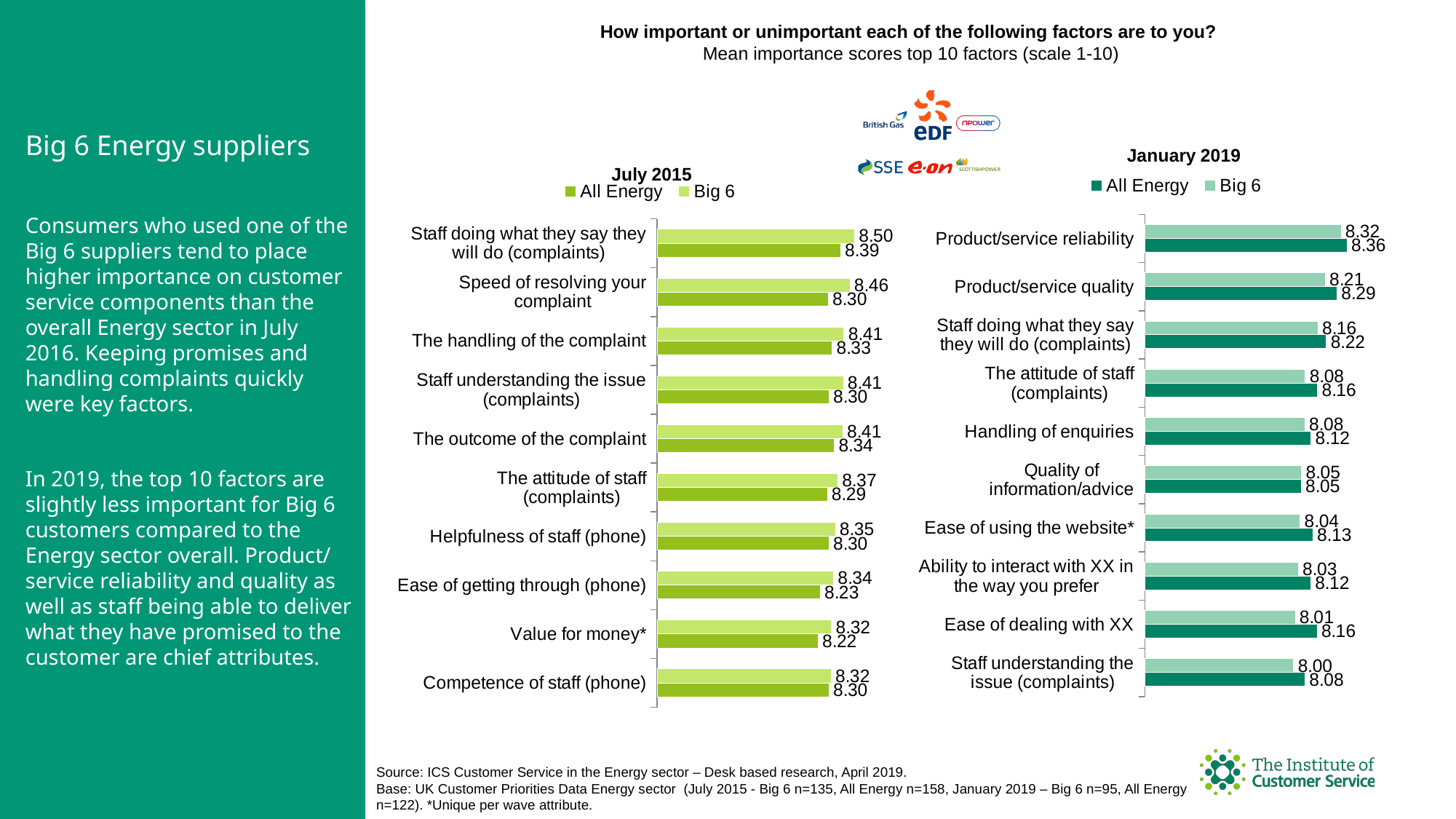
In the July 2015 chart, what is the Big 6 score for 'Staff doing what they say they will do (complaints)'? 8.50 In the July 2015 chart, which factor has the highest Big 6 score? Staff doing what they say they will do (complaints) In the July 2015 chart, what is the difference between the Big 6 and All Energy scores for 'Speed of resolving your complaint'? 0.16 In the January 2019 chart, what is the All Energy score for 'Product/service reliability'? 8.36 What type of chart is used for the July 2015 data? Bar chart How many series does the legend of the January 2019 chart list? 2 In the July 2015 chart, what is the All Energy score for 'Value for money*'? 8.22 In the January 2019 chart, which factor has the lowest Big 6 score? Staff understanding the issue (complaints) In the January 2019 chart, what is the Big 6 score for 'Ease of dealing with XX'? 8.01 In the January 2019 chart, what is the difference between the All Energy and Big 6 scores for 'Ease of dealing with XX'? 0.15 In the January 2019 chart, which is larger for 'Product/service quality': the Big 6 score or the All Energy score? All Energy How many factors are shown in the July 2015 chart? 10